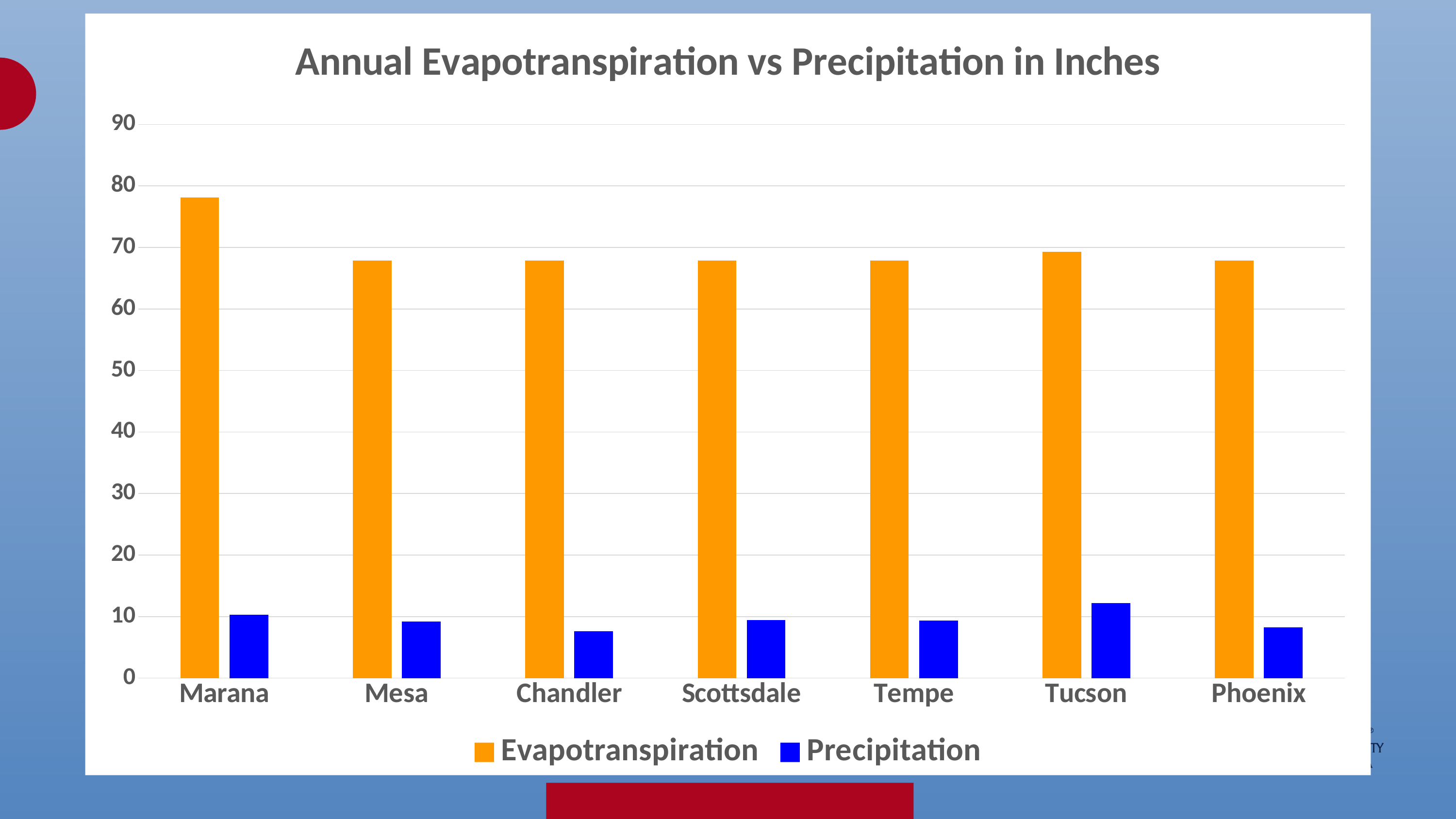
Which colour represents the Precipitation series in the legend? blue Which city has the highest Evapotranspiration value? Marana What type of chart is shown on the slide? bar chart What is the title of the chart? Annual Evapotranspiration vs Precipitation in Inches Is the Precipitation value for Tucson greater or less than 10? greater Is the Precipitation value for Chandler greater or less than 10? less Is the Evapotranspiration value for Marana greater or less than 70? greater Which is larger, the Evapotranspiration value for Marana or for Mesa? Marana Which city has the highest Precipitation value? Tucson How many cities are shown on the x axis? 7 How many series does the legend list? 2